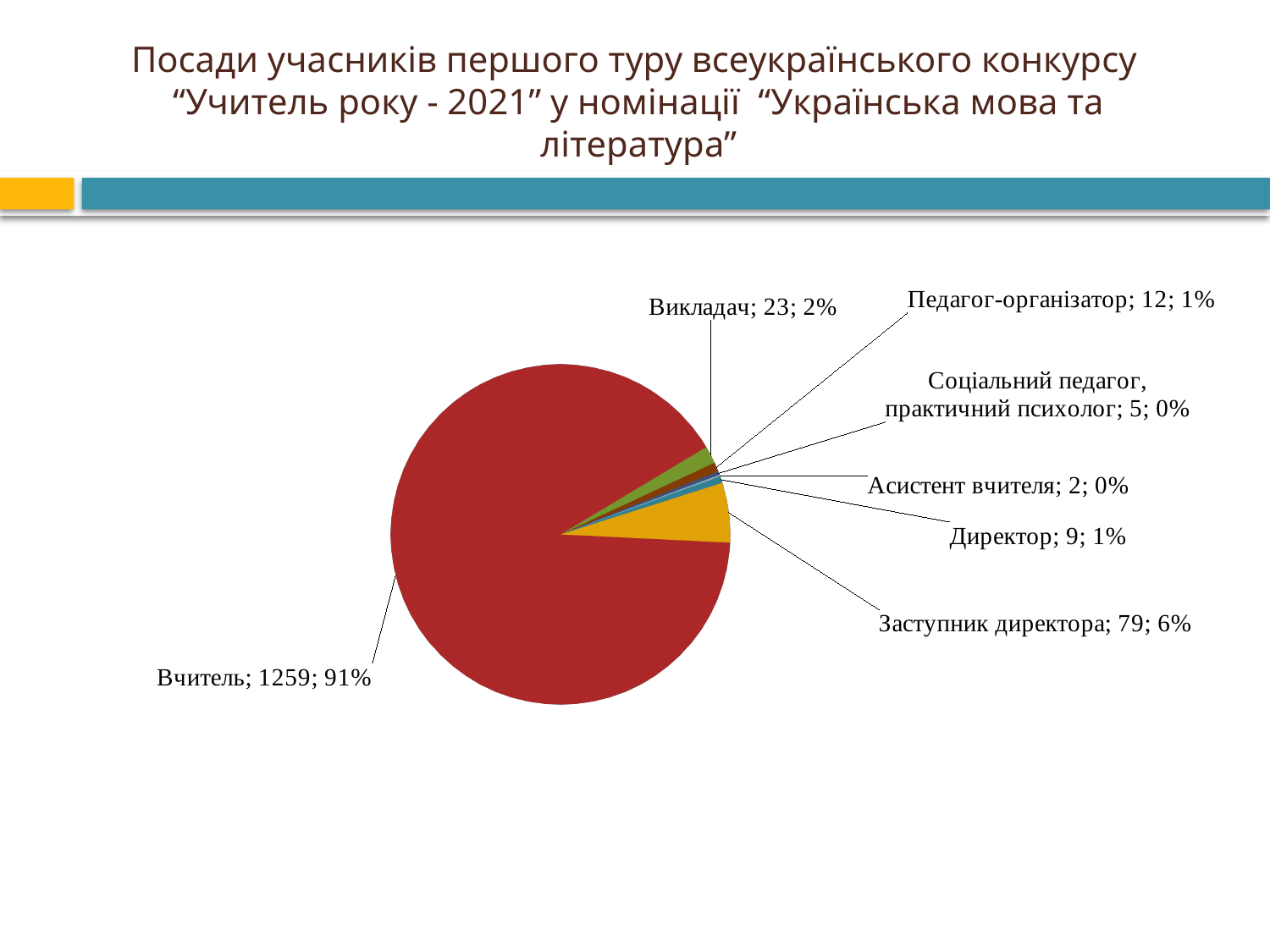
How many categories (slices) does the pie chart have? 7 Which is larger, the value for Директор or the value for Педагог-організатор? Педагог-організатор What is the value for Асистент вчителя? 2 Which category has the largest slice? Вчитель What is the difference between the values for Заступник директора and Викладач? 56 What is the value for Заступник директора? 79 Which category has the smallest slice? Асистент вчителя What is the value for Педагог-організатор? 12 What share of the pie does Заступник директора represent? 6% What is the value for Вчитель? 1259 What kind of chart is shown on the slide? pie chart What is the value for Викладач? 23